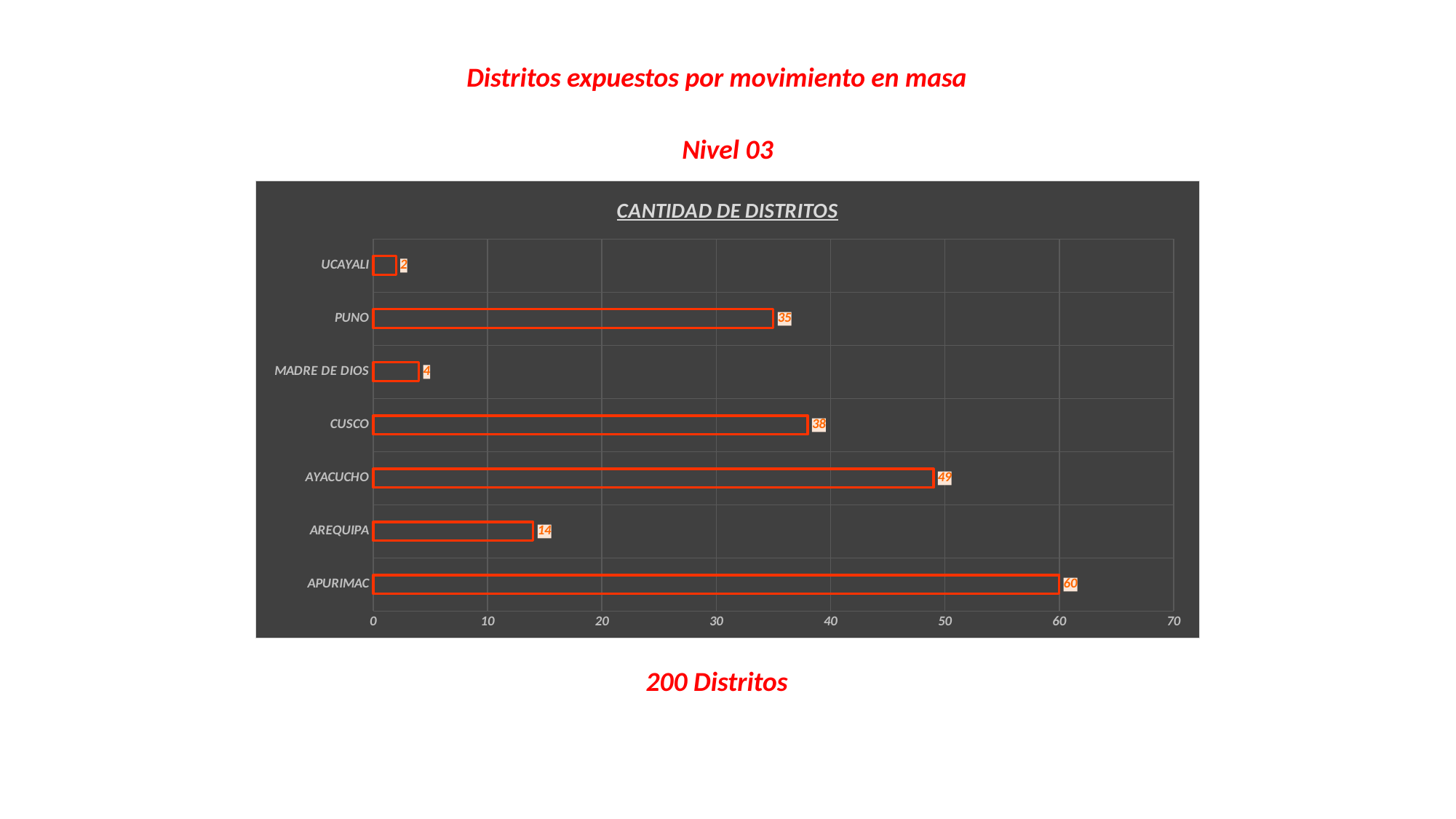
What is the title of the chart? CANTIDAD DE DISTRITOS What is the maximum value shown on the x axis? 70 What is the difference between the values for APURIMAC and PUNO? 25 Which is larger, the value for CUSCO or the value for PUNO? CUSCO Which category has the lowest value? UCAYALI What kind of chart is shown? bar chart What is the value for AYACUCHO? 49 Which category has the highest value? APURIMAC Is the value for AYACUCHO greater or less than 40? greater What is the value for MADRE DE DIOS? 4 How many categories are shown in the chart? 7 What is the value for AREQUIPA? 14